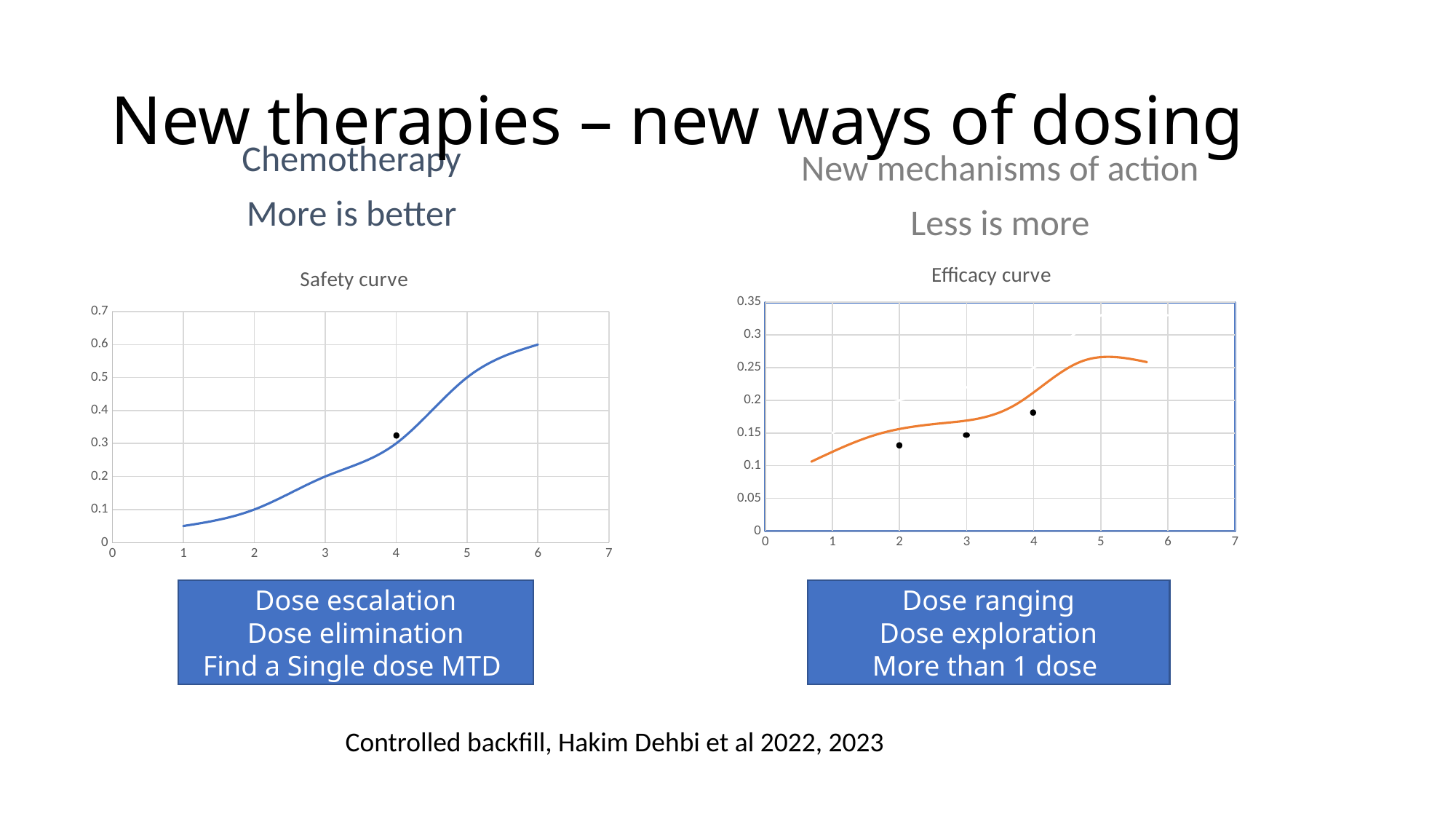
In the Safety curve chart, is the value of the curve at x = 4 greater or less than 0.5? less In the Efficacy curve chart, is the value of the curve at x = 1 greater or less than 0.15? less In the Safety curve chart, is the value of the curve at x = 6 greater or less than 0.5? greater What is the highest tick value on the y axis of the Efficacy curve chart? 0.35 How many black dots are plotted on the Safety curve chart? 1 In the Safety curve chart, does the curve rise or fall as the x value increases from 1 to 6? rises What kind of chart is the Safety curve chart? line chart In the Efficacy curve chart, is the curve higher at x = 5 or at x = 2? x = 5 What kind of chart is the Efficacy curve chart? line chart How many black dots are plotted on the Efficacy curve chart? 3